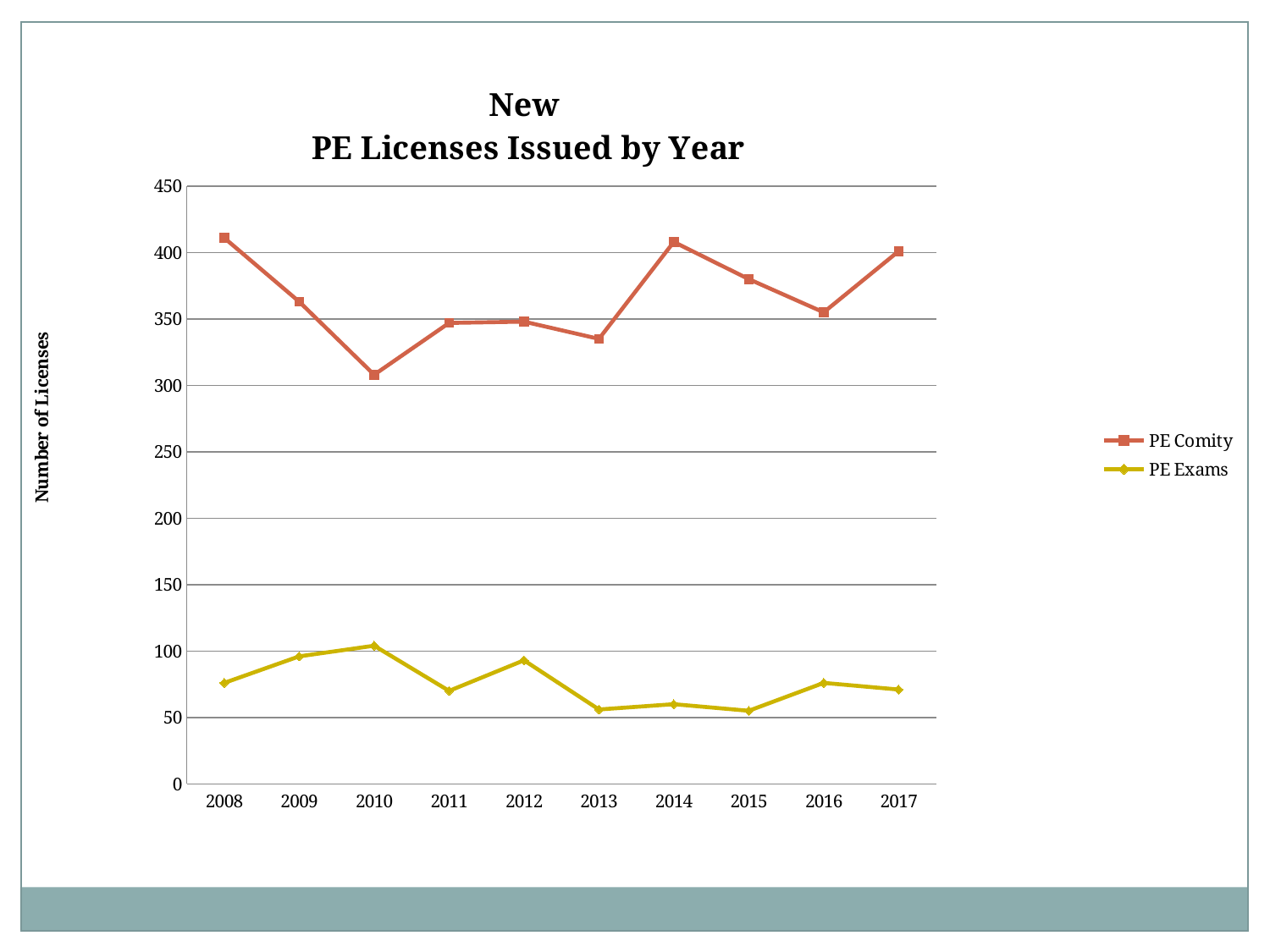
Does the PE Comity line rise or fall from 2008 to 2010? Fall Is the PE Comity value for 2008 greater or less than 400? greater Which year has the larger PE Exams value, 2009 or 2011? 2009 Is the PE Comity value for 2010 greater or less than 350? less Which year has the larger PE Comity value, 2009 or 2010? 2009 What type of chart is shown on the slide? Line chart What is the label on the vertical axis? Number of Licenses In which year was the PE Exams value highest? 2010 In which year was the PE Comity value lowest? 2010 How many series does the legend list? 2 Is the PE Exams value for 2013 greater or less than 100? less How many years are plotted along the x axis? 10